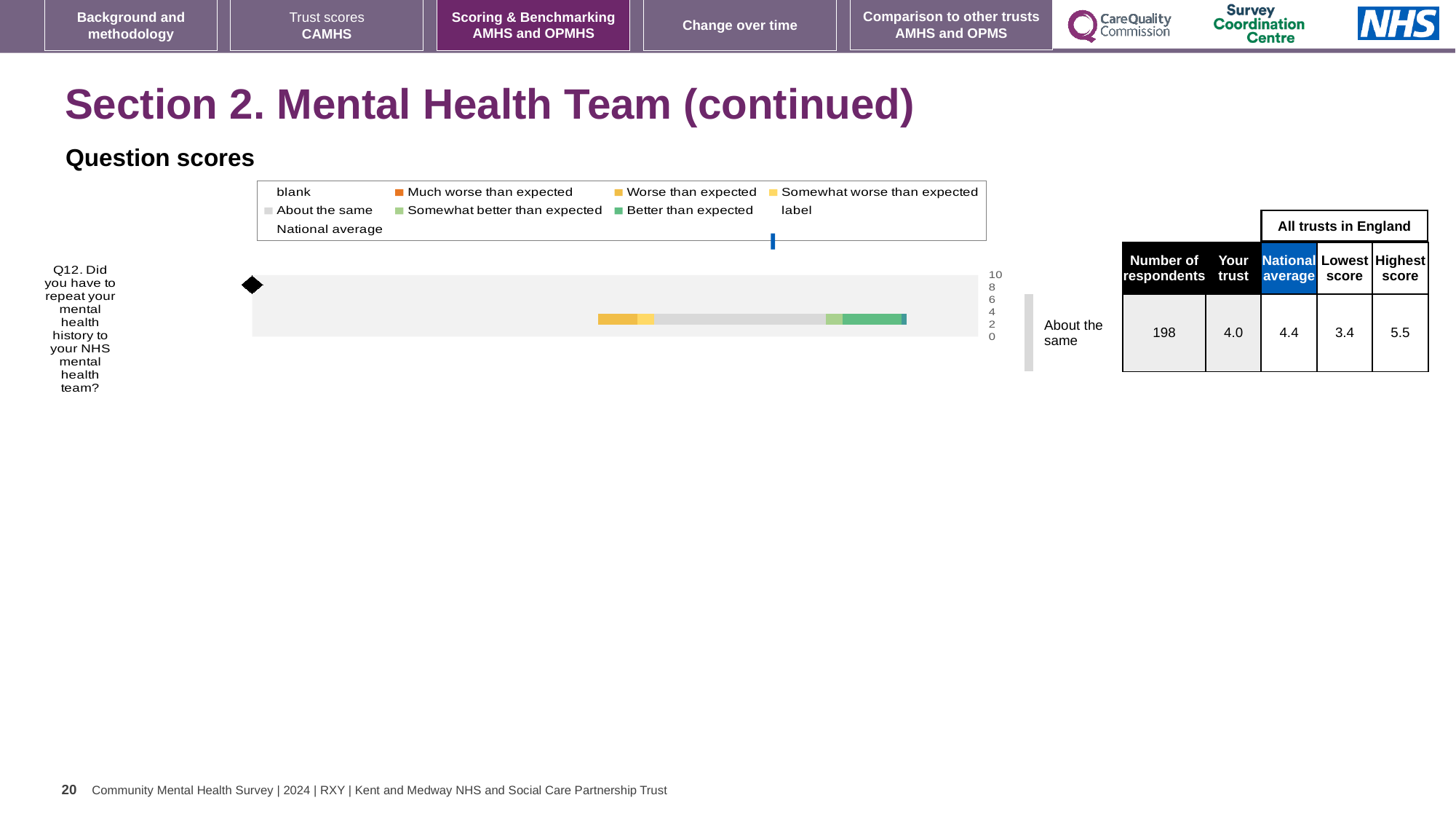
How many questions are plotted on the chart? 1 By how much does the national average exceed the 'Your trust' score for Q12? 0.4 What is the highest score among all trusts in England for Q12? 5.5 What is the number of respondents for Q12? 198 What is the 'Your trust' score for Q12? 4.0 What is the lowest score among all trusts in England for Q12? 3.4 Which benchmark category is the trust's result for Q12 labelled as? About the same Which is larger for Q12, the 'Your trust' score or the national average? National average What is the maximum value shown on the chart's score axis? 10 What is the difference between the highest and lowest scores for Q12? 2.1 What kind of chart is used to show the Q12 question score? bar chart What is the national average score for Q12? 4.4